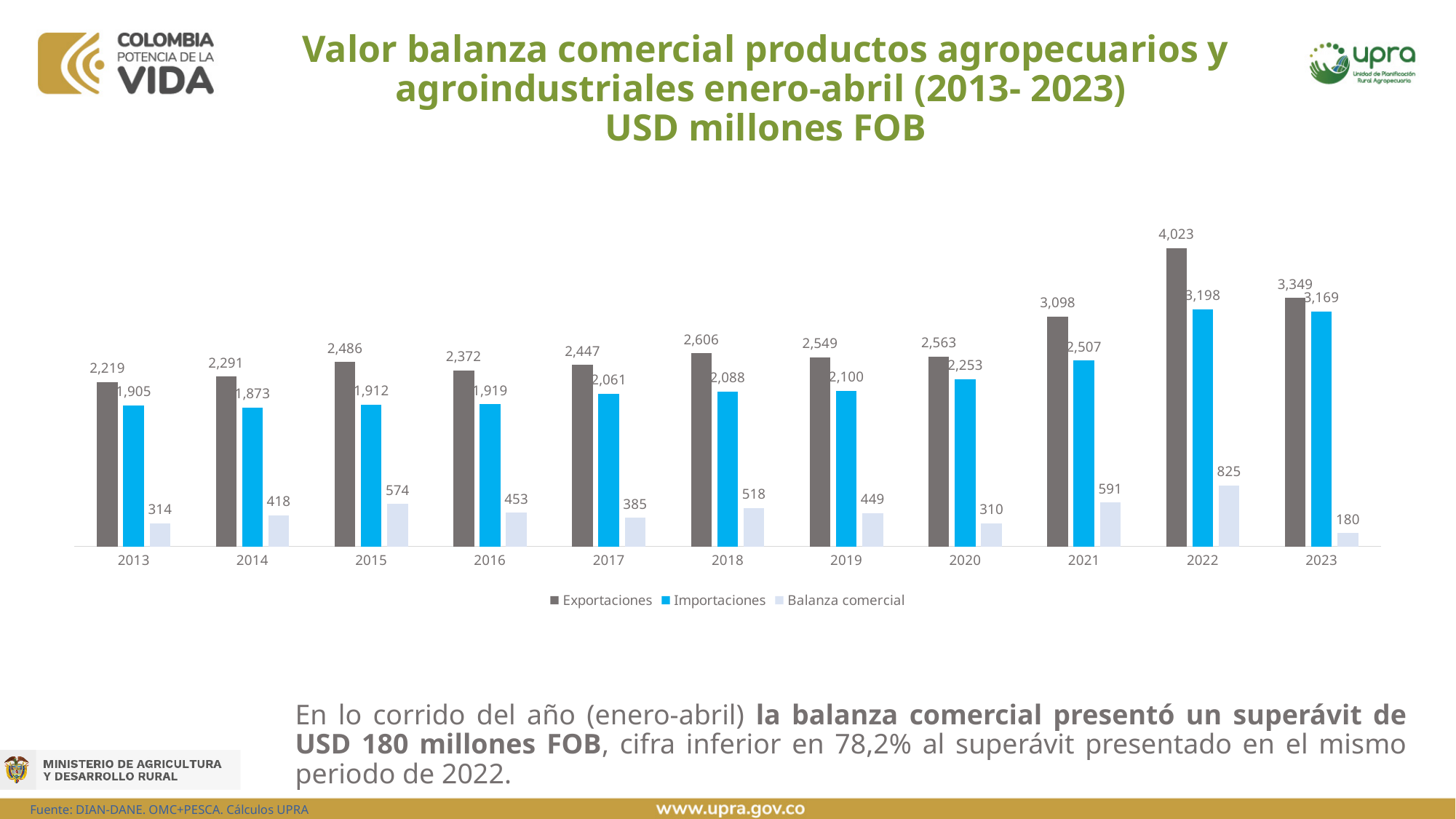
What is the value of Exportaciones for 2022? 4,023 How many years are shown on the x axis? 11 What is the value of Importaciones for 2019? 2,100 Which year has the highest Balanza comercial value? 2022 What is the value of Balanza comercial for 2015? 574 What is the difference between the Balanza comercial values for 2022 and 2023? 645 Which year has the lowest Balanza comercial value? 2023 How many series does the legend list? 3 What is the difference between Exportaciones and Importaciones in 2023? 180 Which is larger, Exportaciones in 2021 or Importaciones in 2022? Importaciones in 2022 Which year has the lowest Importaciones value? 2014 What kind of chart is shown on the slide? Bar chart